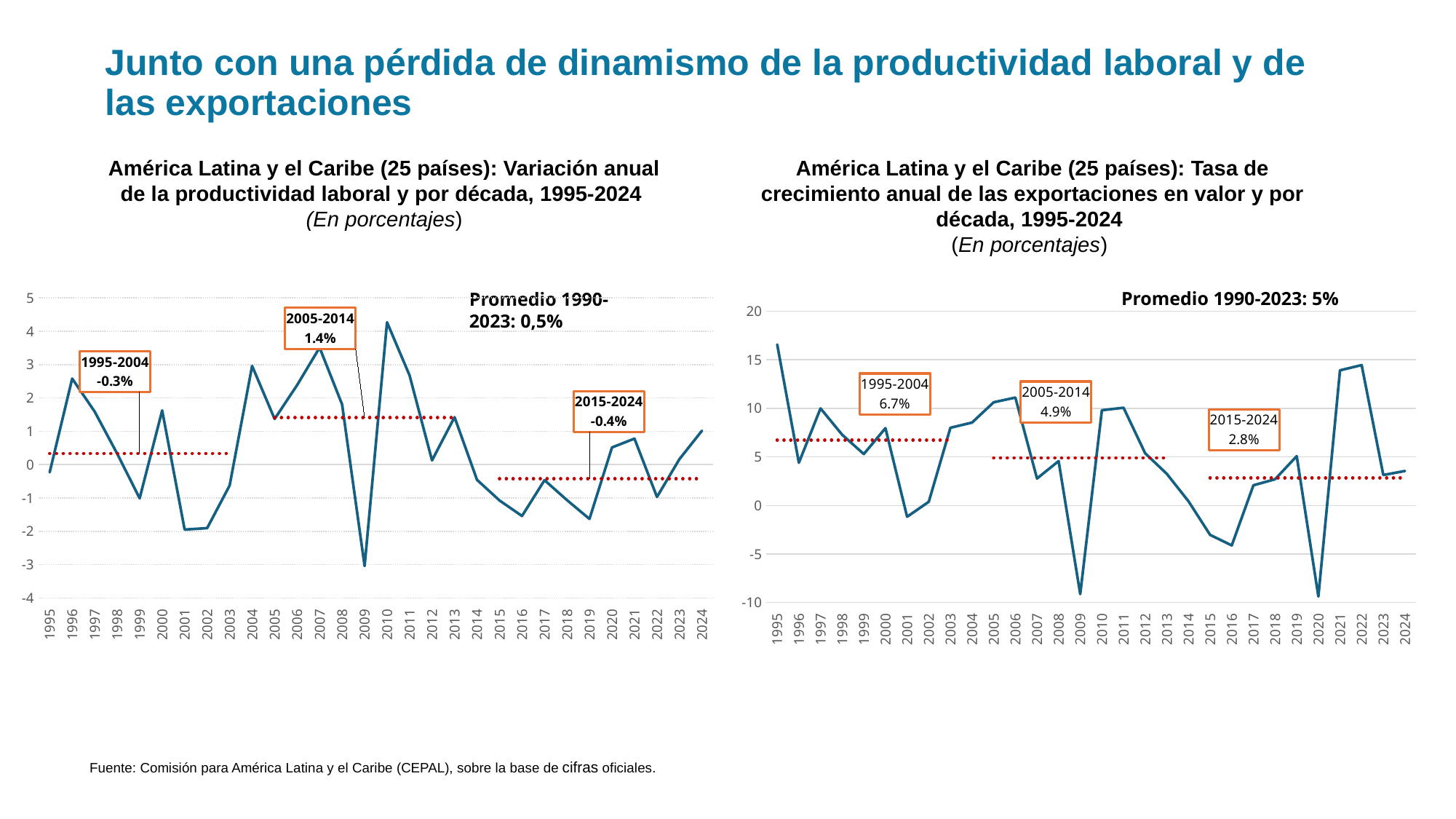
In the right chart (exportaciones), what is the labelled average for 2015-2024? 2.8% In the left chart (productividad laboral), which year has the lowest value? 2009 In the right chart (exportaciones), is the value for 2021 greater or less than 10? greater In the left chart (productividad laboral), what is the labelled average for 2005-2014? 1.4% In the right chart (exportaciones), what is the difference between the 1995-2004 average and the 2015-2024 average? 3.9 percentage points In the left chart (productividad laboral), what is the labelled average for 1995-2004? -0.3% In the left chart (productividad laboral), what is the labelled average for 2015-2024? -0.4% What type of chart is the right chart (exportaciones)? Line chart In the left chart (productividad laboral), is the value for 2009 greater or less than -2? less In the right chart (exportaciones), what is the labelled average for 1995-2004? 6.7% In the right chart (exportaciones), what is the Promedio 1990-2023 shown? 5% In the left chart (productividad laboral), which decade average is larger, 2005-2014 or 2015-2024? 2005-2014